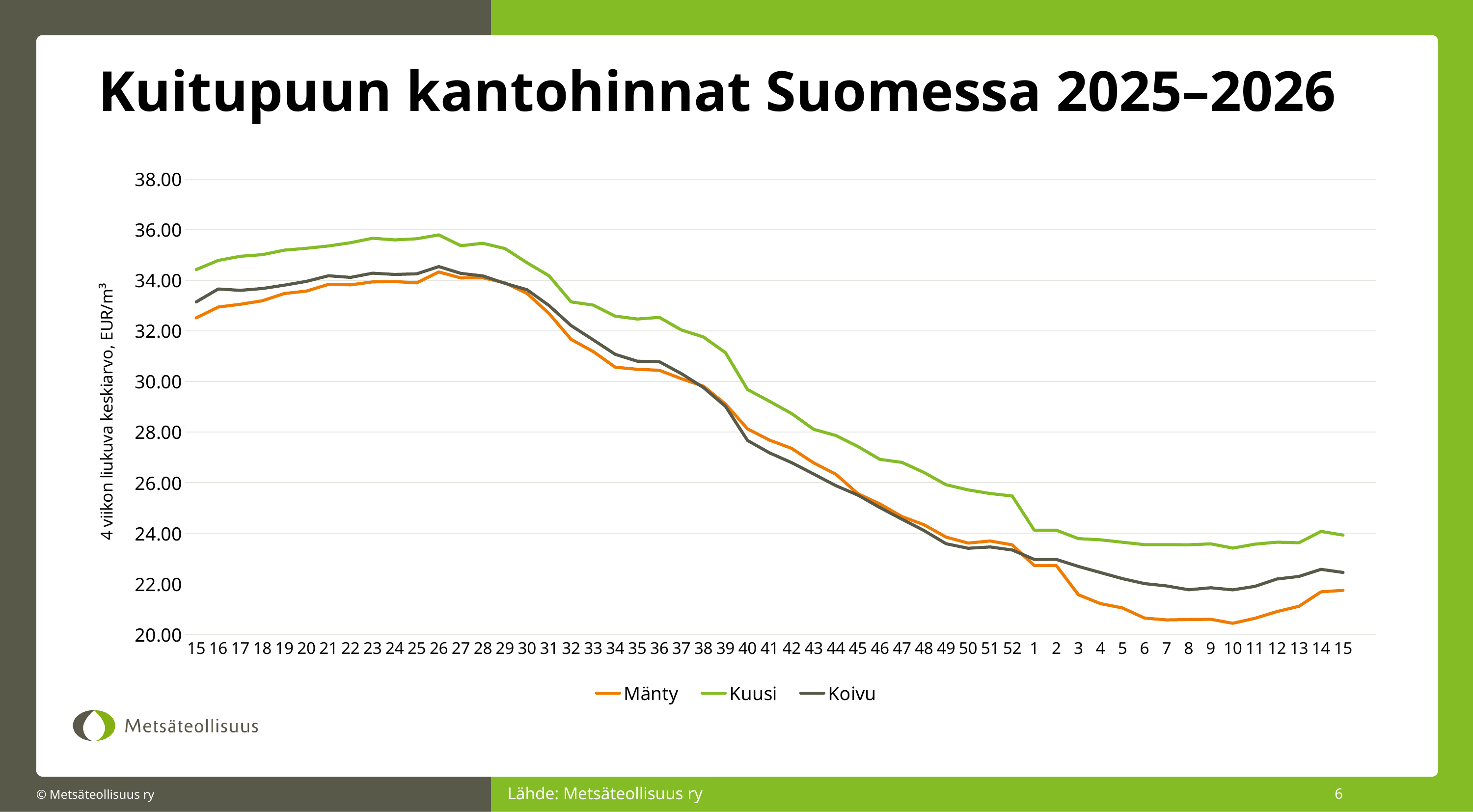
What kind of chart is shown on the slide? Line chart How many series does the legend list? 3 At week 15 on the left of the chart, which is higher, Kuusi or Mänty? Kuusi Is the value for Mänty at week 10 greater or less than 22.00? less What is the title of the chart? Kuitupuun kantohinnat Suomessa 2025–2026 Which series has the highest value at week 26? Kuusi At week 10, which is higher, Koivu or Mänty? Koivu Which series has the lowest value at week 10? Mänty Is the value for Koivu at week 52 greater or less than 24.00? less Does the Mänty series rise or fall from week 28 to week 10? Fall Which series are listed in the legend? Mänty, Kuusi, Koivu Is the value for Kuusi at week 26 greater or less than 34.00? greater